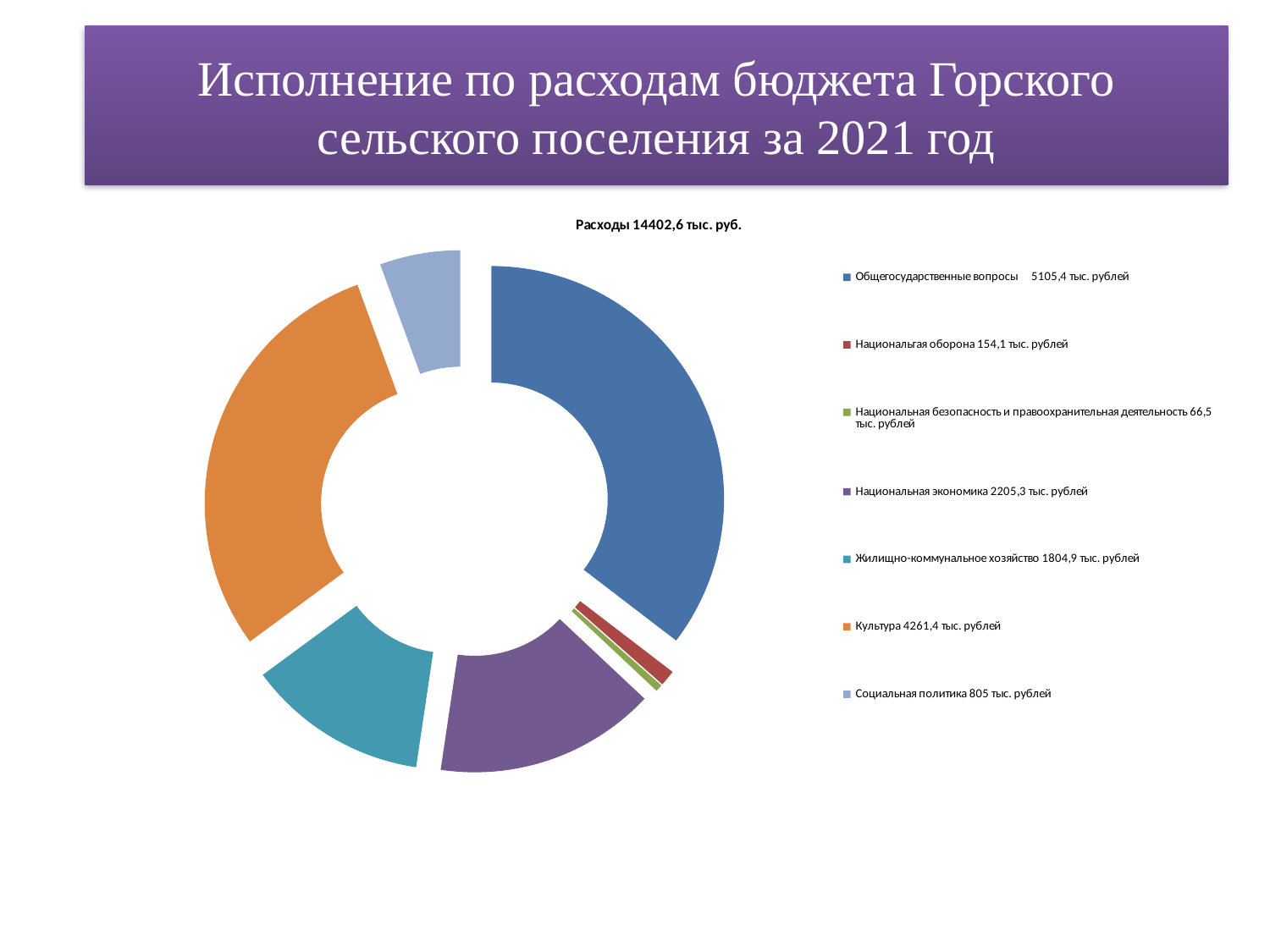
What is the difference between Общегосударственные вопросы and Культура? 844 тыс. рублей How many categories does the chart show? 7 What is the value for Социальная политика? 805 тыс. рублей What is the value for Общегосударственные вопросы? 5105,4 тыс. рублей Which category has the smallest value? Национальная безопасность и правоохранительная деятельность Which is larger, Национальная экономика or Жилищно-коммунальное хозяйство? Национальная экономика What is the title of the chart? Расходы 14402,6 тыс. руб. What is the value for Жилищно-коммунальное хозяйство? 1804,9 тыс. рублей What is the value for Культура? 4261,4 тыс. рублей What kind of chart is shown on the slide? Doughnut (pie) chart Which category has the largest value? Общегосударственные вопросы What is the difference between Национальная экономика and Жилищно-коммунальное хозяйство? 400,4 тыс. рублей